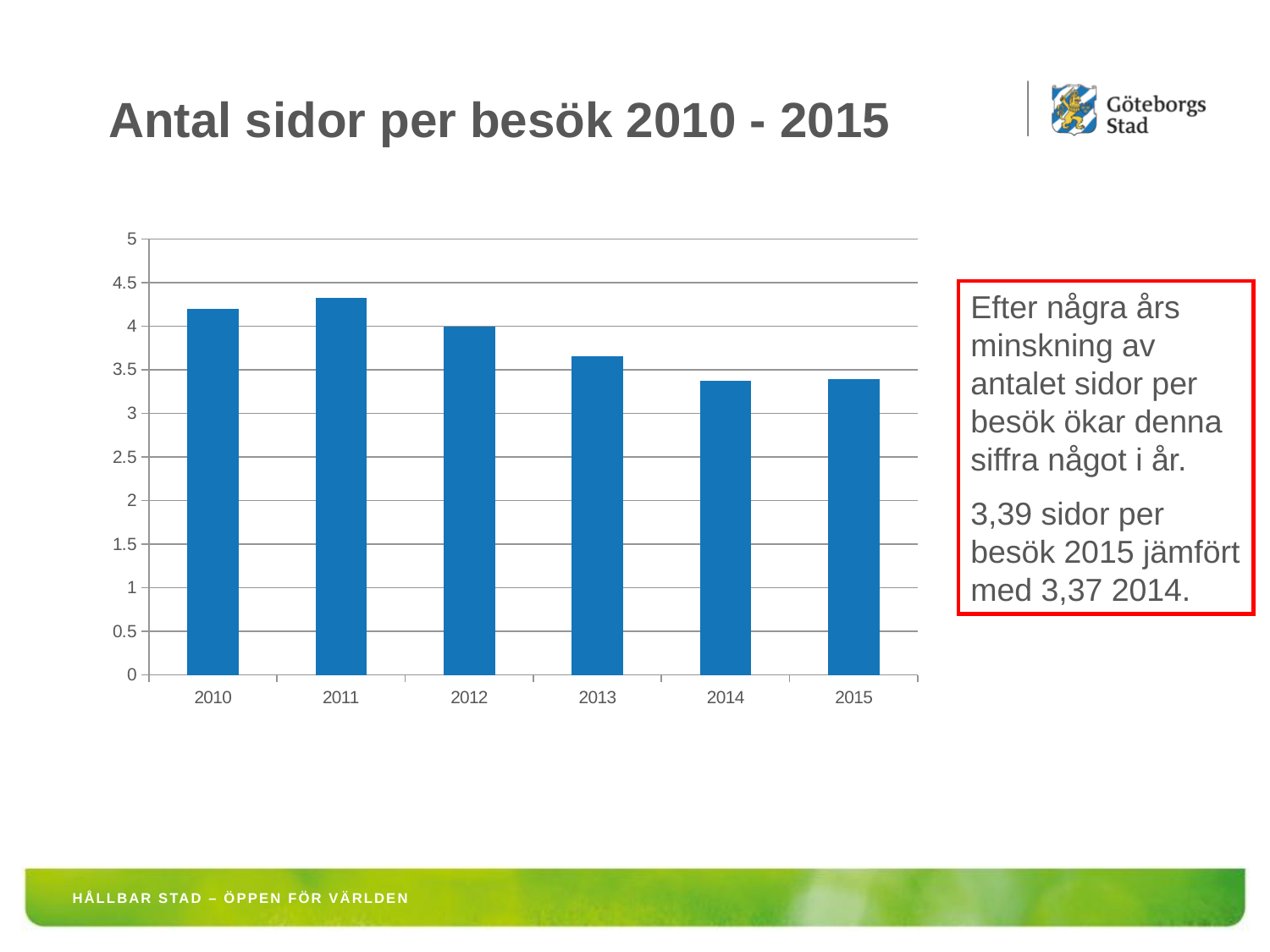
How many years are shown on the x axis of the chart? 6 What is the title of the slide containing the chart? Antal sidor per besök 2010 - 2015 Is the value for 2011 greater or less than 4.5? less Do the values generally rise or fall from 2011 to 2014? fall Is the value for 2013 greater or less than 3.5? greater Is the value for 2010 greater or less than 4? greater According to the slide, how many pages per visit were there in 2015? 3,39 What kind of chart is shown on the slide? bar chart According to the slide, how many pages per visit were there in 2014? 3,37 Which is larger, the value for 2010 or the value for 2013? 2010 Which year has the highest number of pages per visit? 2011